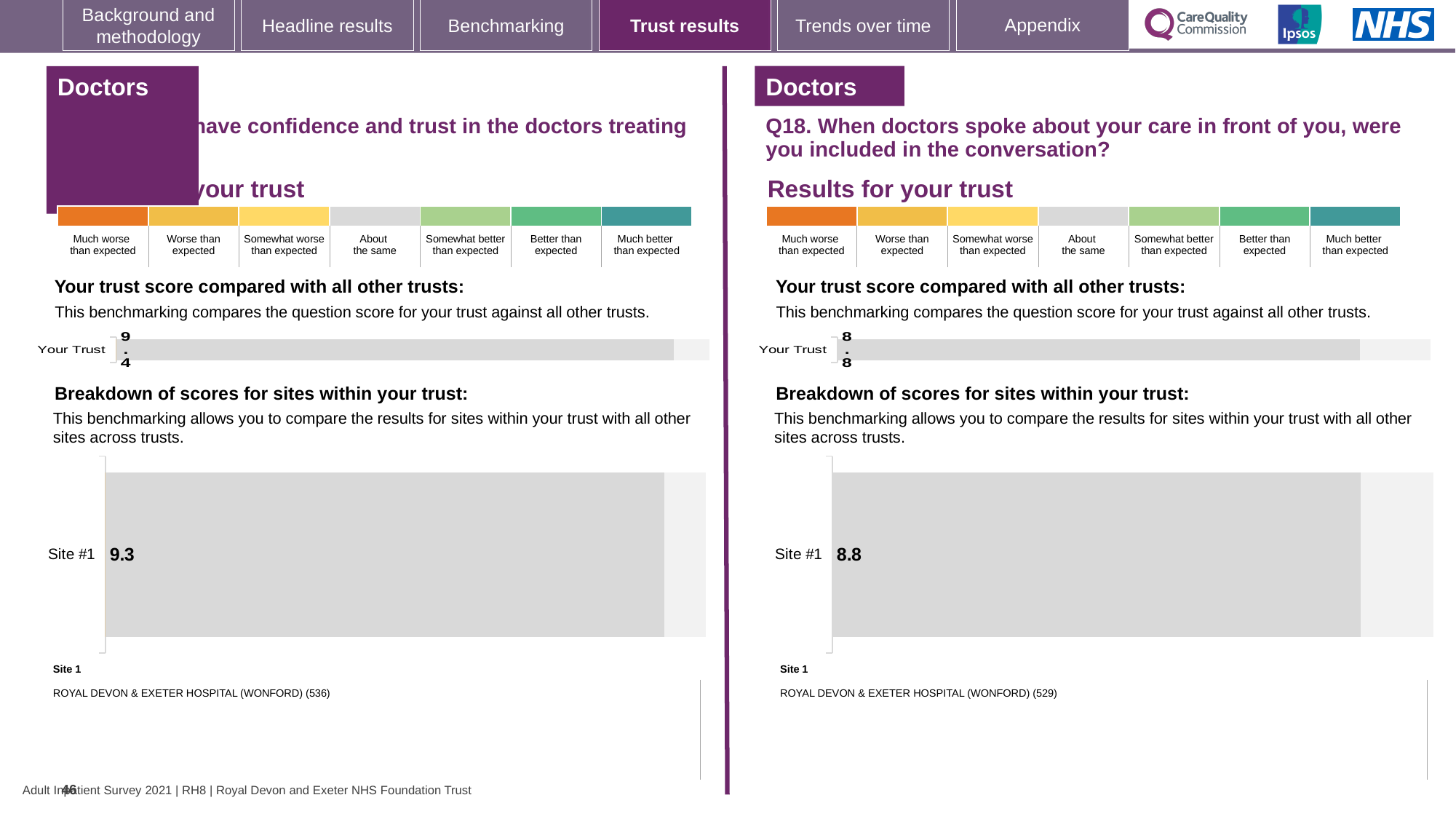
How many bars are plotted in the left-hand 'Your Trust' benchmarking chart? 1 In the left-hand 'Breakdown of scores for sites within your trust' chart, what is the score for Site #1? 9.3 In the right-hand (Q18) 'Breakdown of scores for sites within your trust' chart, what is the score for Site #1? 8.8 What is the difference between the 'Your Trust' score on the left half of the slide and the 'Your Trust' score on the right half (Q18)? 0.6 Which site is listed as Site 1 beneath the right-hand (Q18) site breakdown chart? ROYAL DEVON & EXETER HOSPITAL (WONFORD) (529) On the right half of the slide (Q18), what is the 'Your Trust' score shown in the trust benchmarking bar chart? 8.8 On the left half of the slide, what is the 'Your Trust' score shown in the trust benchmarking bar chart? 9.4 On the left half of the slide, what is the difference between the 'Your Trust' score and the Site #1 score? 0.1 How many sites are shown in the right-hand (Q18) 'Breakdown of scores for sites within your trust' chart? 1 What kind of chart is used to show the Site #1 score in the left-hand site breakdown? Bar chart What is the title of the question shown on the right half of the slide? Q18. When doctors spoke about your care in front of you, were you included in the conversation? Which is larger: the Site #1 score in the left-hand site breakdown chart or the Site #1 score in the right-hand (Q18) site breakdown chart? Left-hand chart (9.3)